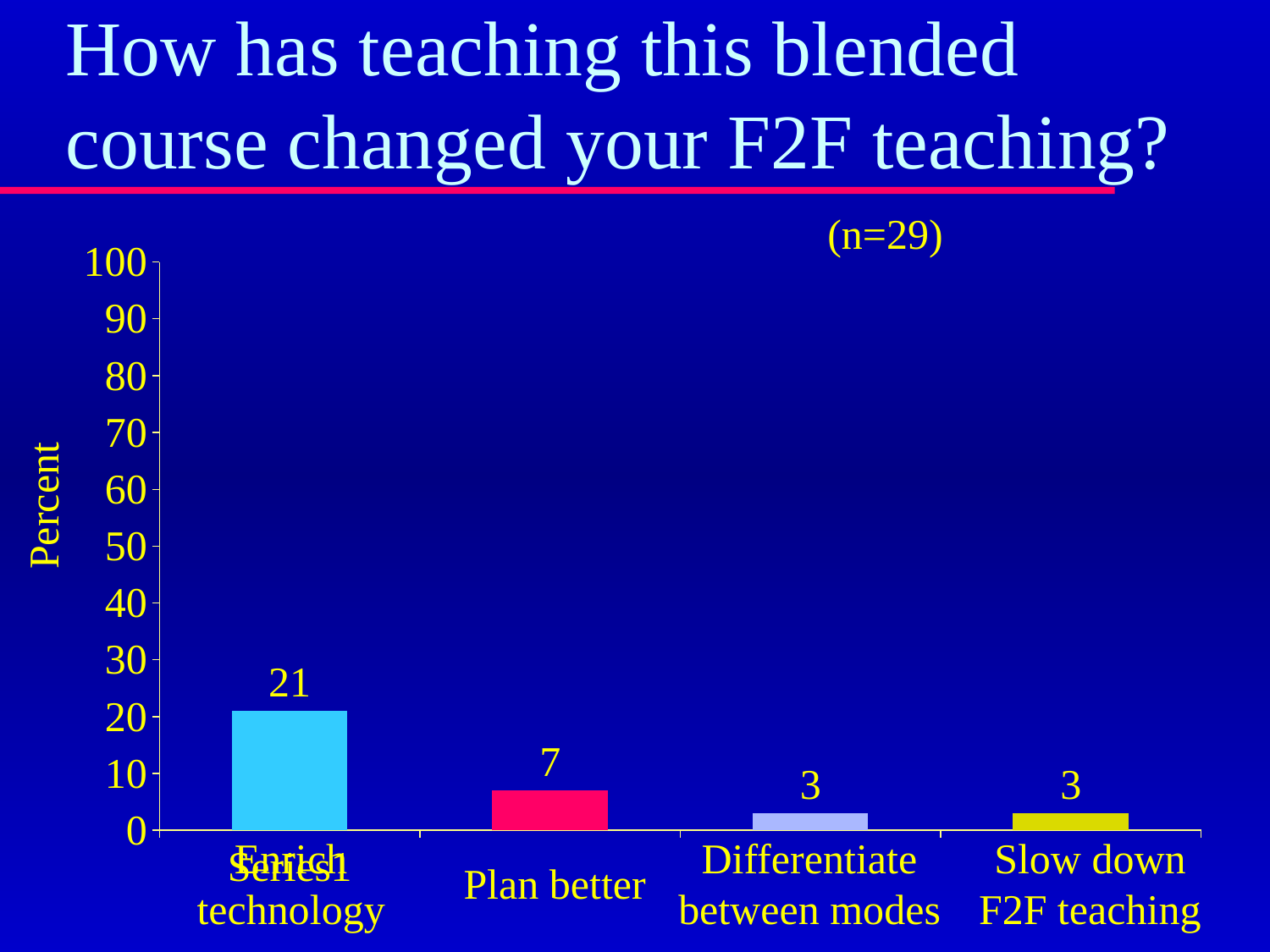
What is the difference between the value for Enrich technology and the value for Plan better? 14 What is the label of the vertical axis? Percent Which is larger, the value for Plan better or the value for Differentiate between modes? Plan better What is the value of the leftmost bar (Enrich technology)? 21 What is the value for Plan better? 7 What type of chart is shown on the slide? bar chart How many categories are shown on the x axis? 4 What is the value for Differentiate between modes? 3 What is the value for Slow down F2F teaching? 3 Is the value for Enrich technology greater or less than 30? less What is the difference between the value for Plan better and the value for Slow down F2F teaching? 4 Which category has the highest value? Enrich technology